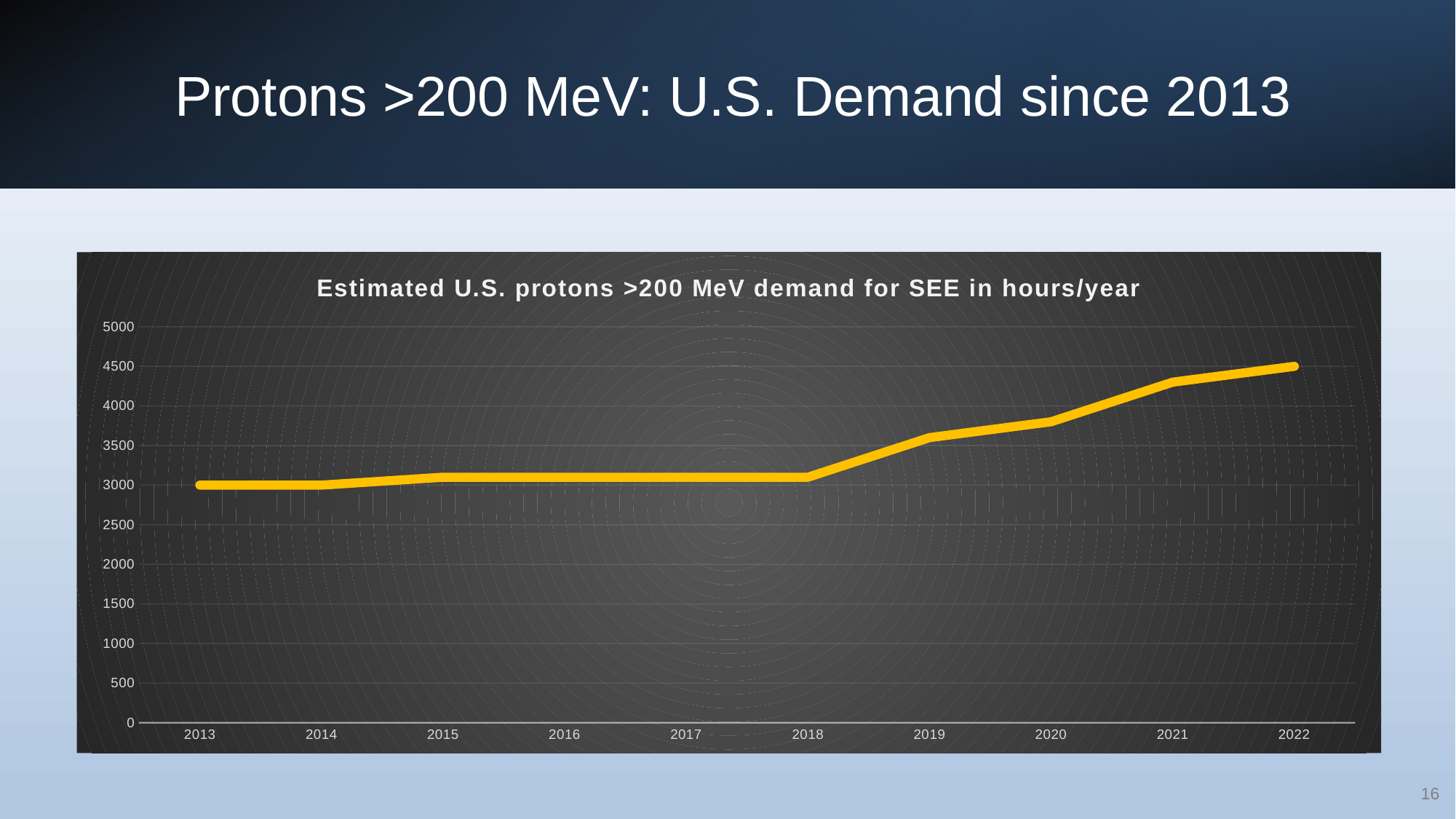
What is the estimated demand in 2013? 3000 What is the estimated demand in 2022? 4500 Is the value for 2019 greater or less than 3500? greater How many years are plotted on the x axis? 10 Do the values generally rise or fall from 2013 to 2022? rise Which year has the larger value, 2016 or 2021? 2021 Is the value for 2017 greater or less than 3500? less What kind of chart is shown on the slide? line chart Is the value for 2021 greater or less than 4000? greater What is the title of the chart? Estimated U.S. protons >200 MeV demand for SEE in hours/year Which year has the highest estimated demand? 2022